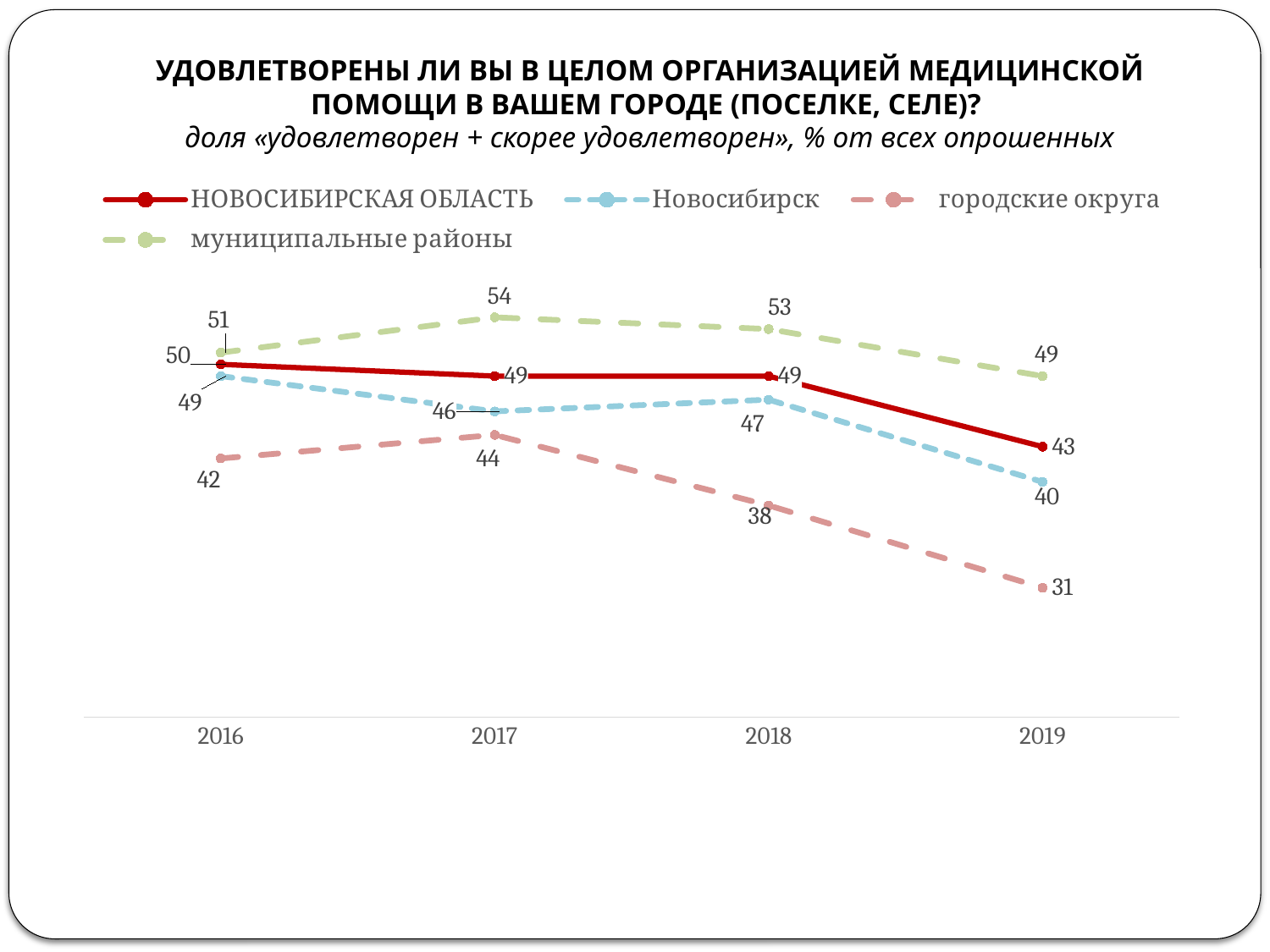
In which year does the городские округа series have its lowest value? 2019 Which series has the higher value in 2019: НОВОСИБИРСКАЯ ОБЛАСТЬ or городские округа? НОВОСИБИРСКАЯ ОБЛАСТЬ What kind of chart is shown on the slide? line chart What value is shown for Новосибирск in 2016? 49 What is the difference between the 2016 and 2019 values for Новосибирск? 9 What value is shown for городские округа in 2018? 38 How many years are shown on the x axis? 4 How many series does the legend list? 4 Does the городские округа series rise or fall from 2017 to 2019? fall What value is shown for НОВОСИБИРСКАЯ ОБЛАСТЬ in 2019? 43 What value is shown for муниципальные районы in 2017? 54 In which year does the муниципальные районы series reach its highest value? 2017